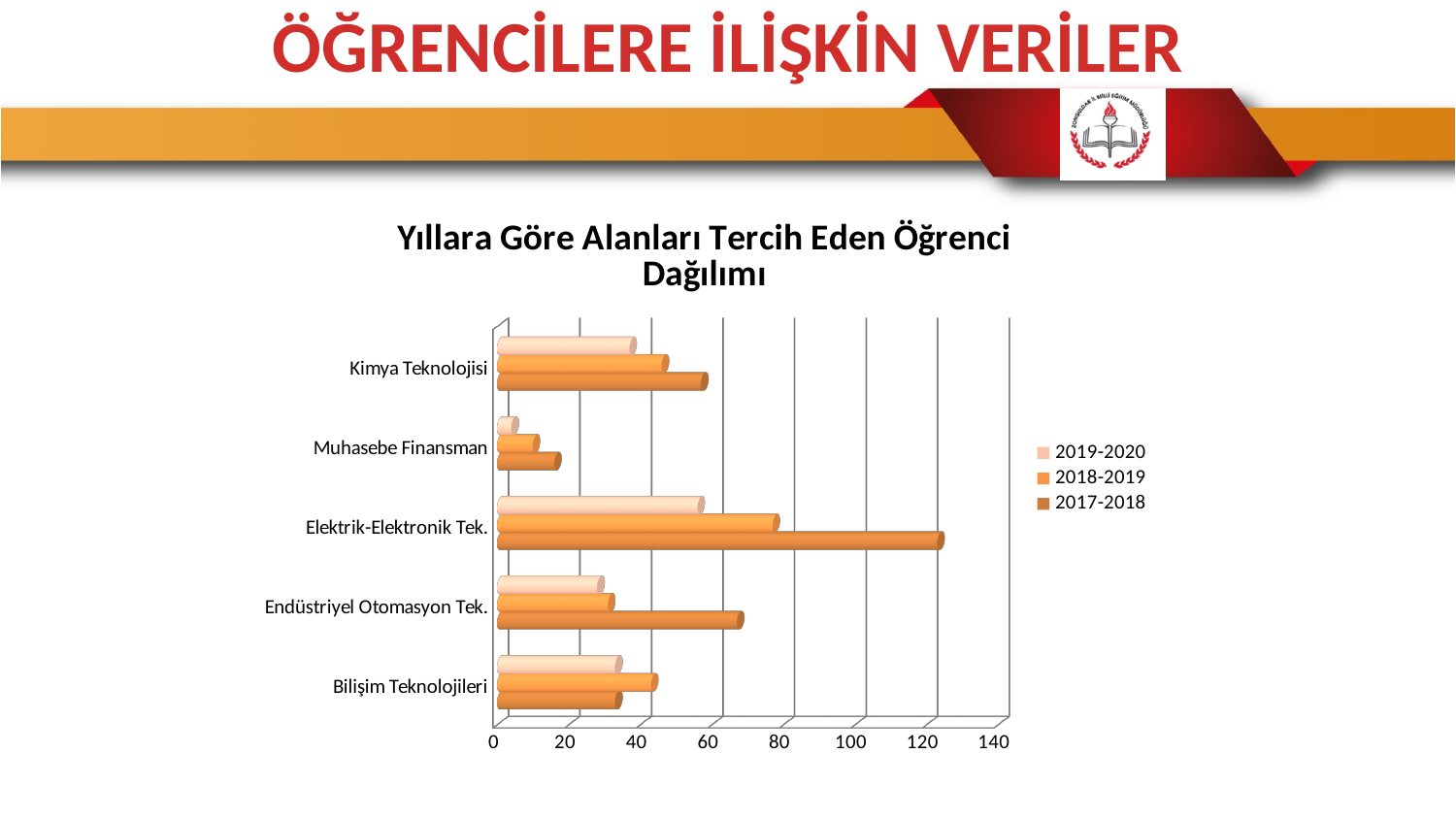
Is the 2017-2018 value for Elektrik-Elektronik Tek. greater or less than 100? greater How many categories (alanlar) are shown on the vertical axis? 5 Is the 2017-2018 value for Endüstriyel Otomasyon Tek. greater or less than 60? greater What kind of chart is shown on the slide? Bar chart Which category has the highest value for 2017-2018? Elektrik-Elektronik Tek. For 2018-2019, which is larger: Elektrik-Elektronik Tek. or Kimya Teknolojisi? Elektrik-Elektronik Tek. Which category has the highest value for 2019-2020? Elektrik-Elektronik Tek. How many series does the legend list? 3 Which category has the lowest value for 2017-2018? Muhasebe Finansman For 2017-2018, which is larger: Kimya Teknolojisi or Endüstriyel Otomasyon Tek.? Endüstriyel Otomasyon Tek. Is the 2018-2019 value for Muhasebe Finansman greater or less than 20? less What is the title of the chart? Yıllara Göre Alanları Tercih Eden Öğrenci Dağılımı